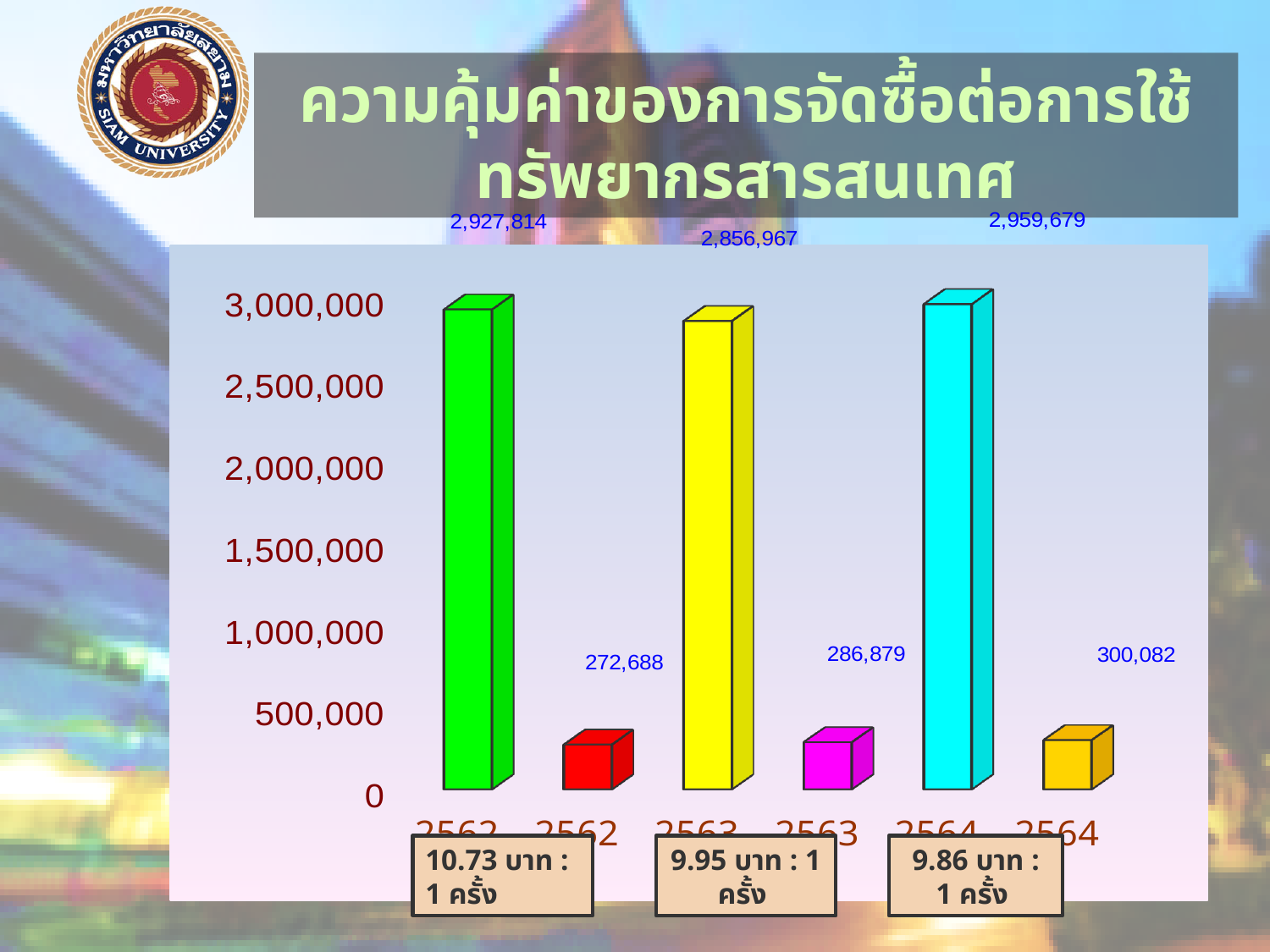
What value is labelled on the tall green bar for 2562? 2,927,814 What value is labelled on the tall yellow bar for 2563? 2,856,967 Which year has the lowest value among the tall bars? 2563 What is the difference between the short bar values for 2564 and 2562? 27,394 What value is labelled on the short magenta bar for 2563? 286,879 What value is labelled on the short orange bar for 2564? 300,082 Is the short bar value for 2563 greater or less than 500,000? less What value is labelled on the tall cyan bar for 2564? 2,959,679 What value is labelled on the short red bar for 2562? 272,688 Which year has the highest value among the tall bars? 2564 Do the short bar values rise or fall from 2562 to 2564? rise How many bars are plotted in the chart? 6